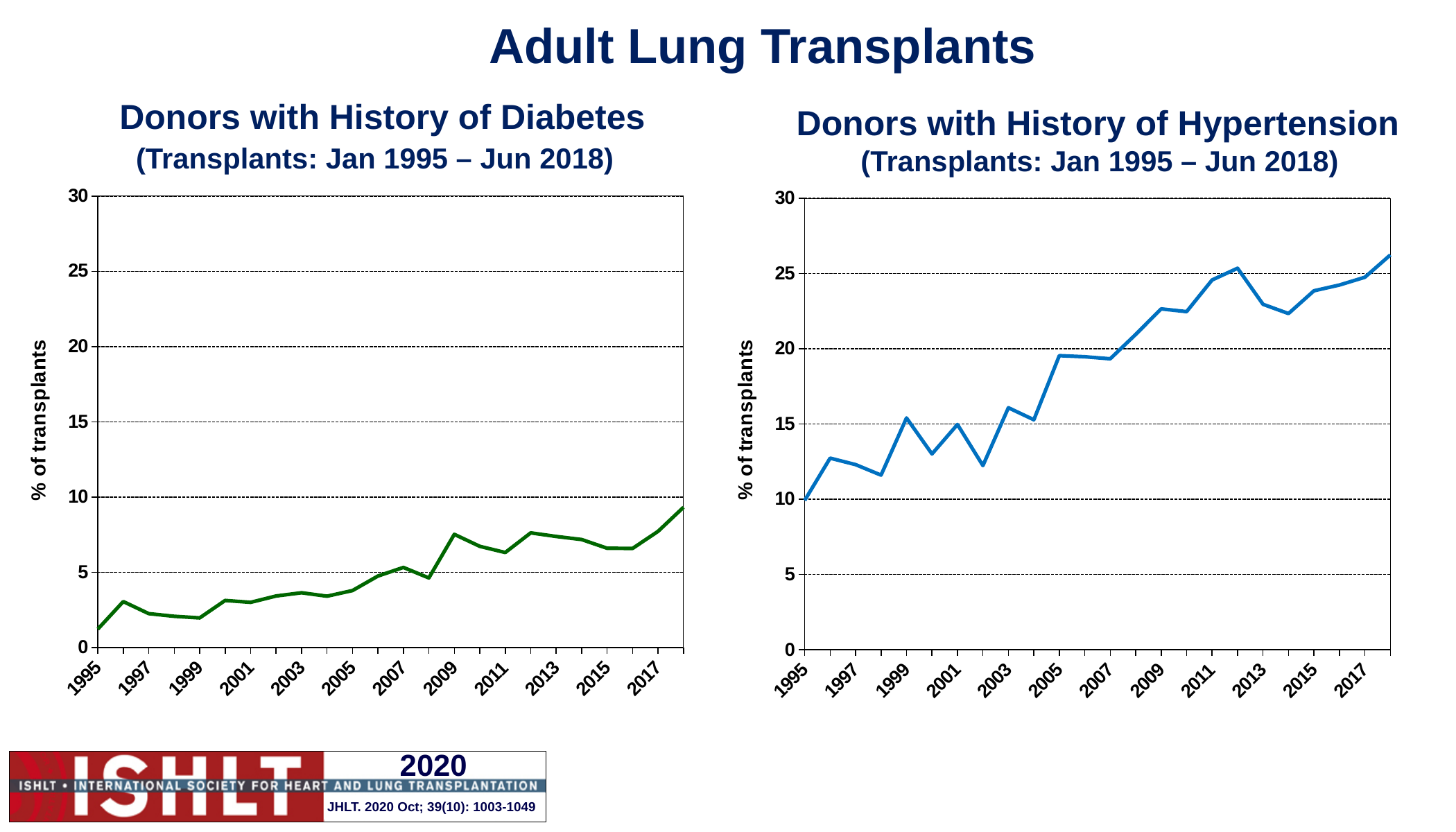
What kind of chart is the 'Donors with History of Diabetes' chart? line chart In the 'Donors with History of Hypertension' chart, which year has the highest value? 2018 In the 'Donors with History of Hypertension' chart, which is larger, the value for 2012 or the value for 2014? 2012 In the 'Donors with History of Hypertension' chart, is the value for 2018 greater or less than 25? greater In the 'Donors with History of Diabetes' chart, is the value for 2009 greater or less than 5? greater In the 'Donors with History of Diabetes' chart, which year has the lowest value? 1995 In the 'Donors with History of Diabetes' chart, do the values generally rise or fall from 1995 to 2018? rise In the 'Donors with History of Hypertension' chart, is the value for 2003 greater or less than 15? greater What is the y-axis label on the 'Donors with History of Hypertension' chart? % of transplants In the 'Donors with History of Diabetes' chart, which is larger, the value for 2018 or the value for 2013? 2018 In the 'Donors with History of Hypertension' chart, do the values generally rise or fall from 1995 to 2018? rise